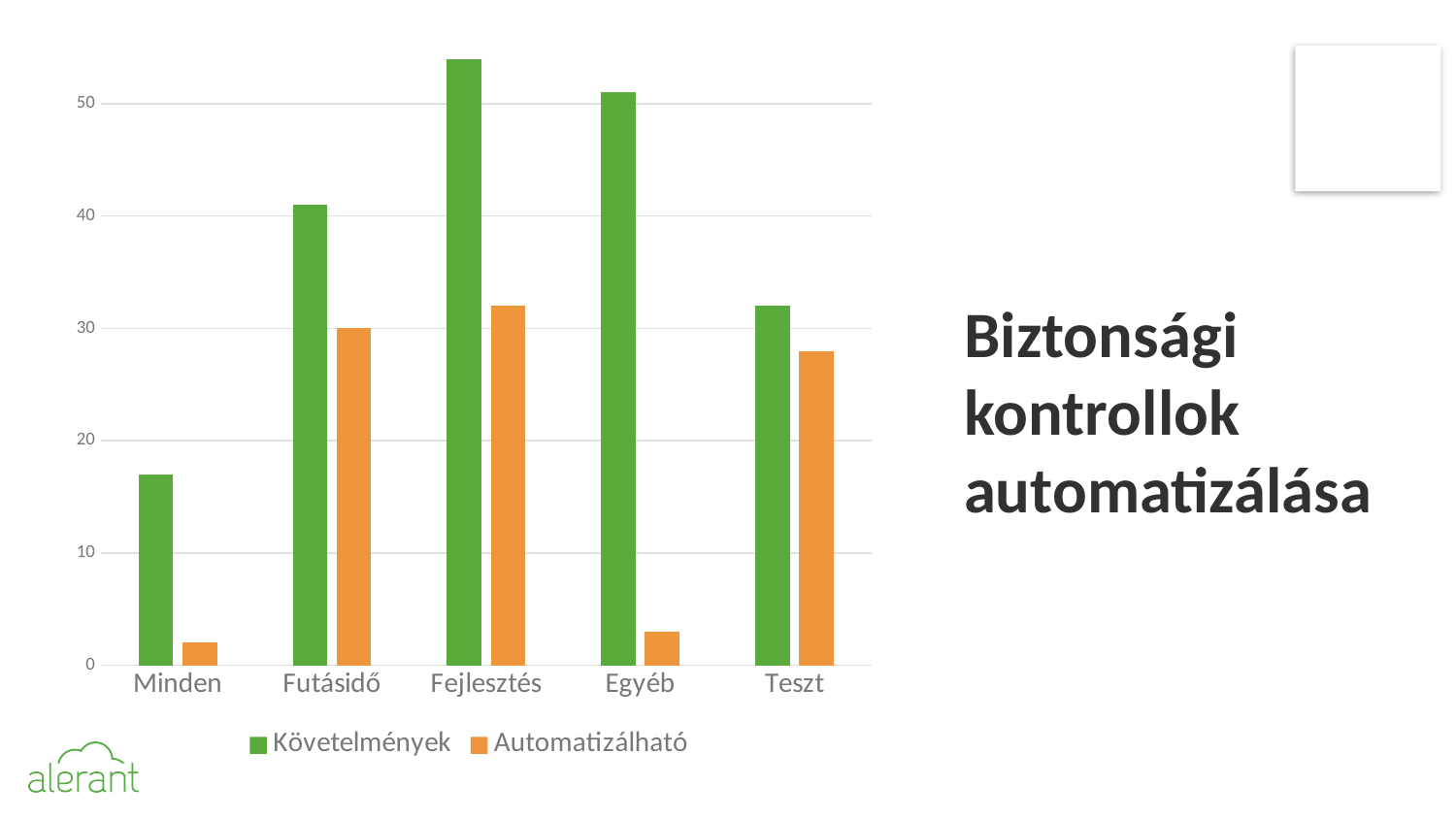
Is the Automatizálható value for Teszt greater or less than 30? less How many series does the chart's legend list? 2 Which category has the lowest Automatizálható value? Minden Which category has the highest Automatizálható value? Fejlesztés Which category has the lowest Követelmények value? Minden Which colour represents the Automatizálható series in the chart? orange Is the Követelmények value for Minden greater or less than 20? less What kind of chart is shown on the slide? bar chart How many categories are shown on the x axis of the chart? 5 Which category has the highest Követelmények value? Fejlesztés Which is larger for Egyéb: the Követelmények value or the Automatizálható value? Követelmények